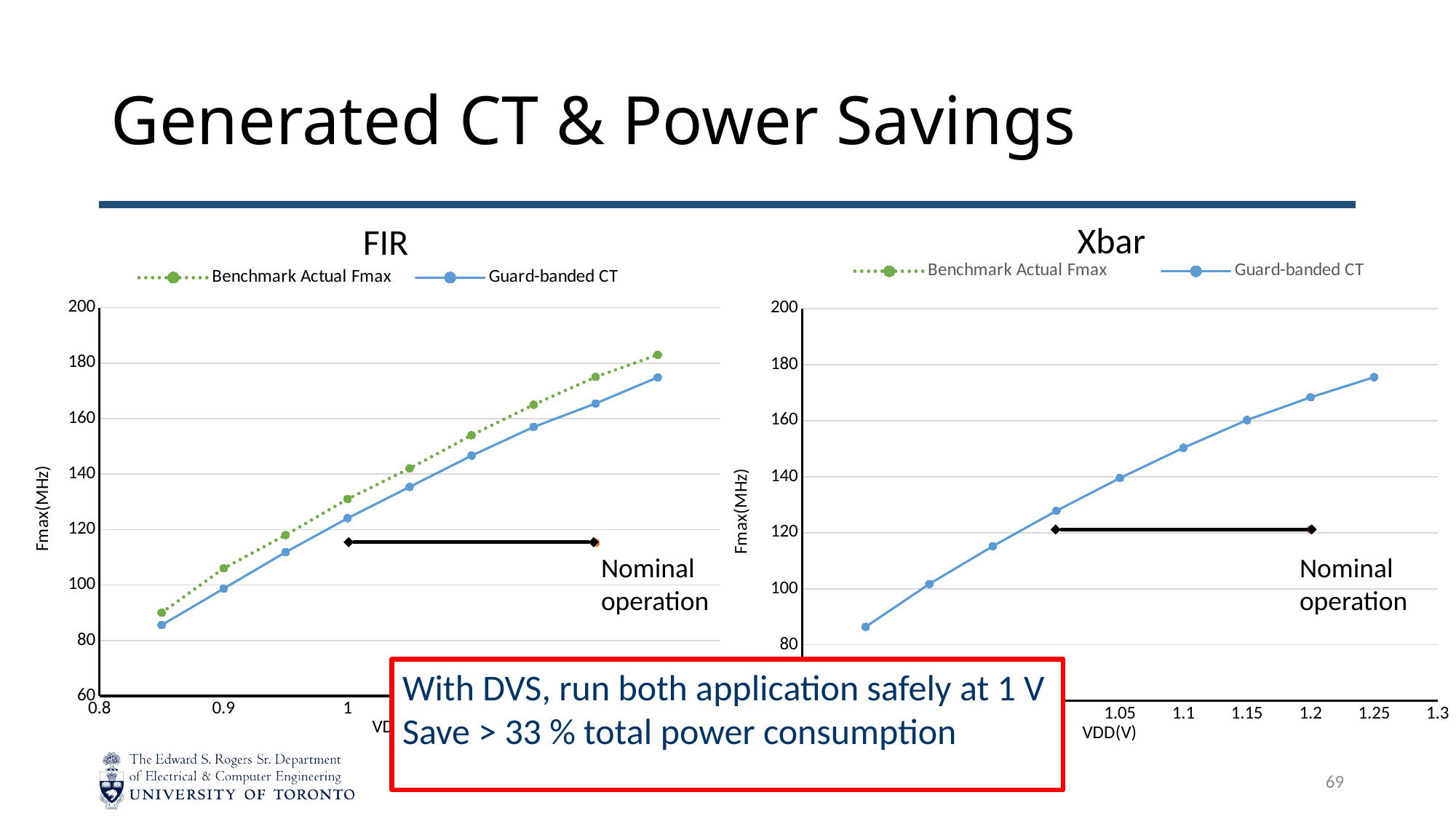
In the FIR chart, is the Benchmark Actual Fmax value at 0.9 V greater or less than 100? greater In the Xbar chart, is the Guard-banded CT value at 1.2 V greater or less than 160? greater What kind of chart is the FIR chart? line chart How many data points are plotted for the Guard-banded CT series in the Xbar chart? 9 In the Xbar chart, is the Guard-banded CT value at 1.25 V greater or less than 180? less In the FIR chart, at 1.2 V, which series has the higher value: Benchmark Actual Fmax or Guard-banded CT? Benchmark Actual Fmax In the FIR chart, do the Guard-banded CT values rise or fall as VDD increases? rise In the Xbar chart, at which VDD value does the Guard-banded CT series reach its highest point? 1.25 How many series does the legend of the Xbar chart list? 2 In the FIR chart, which series is shown with a dotted green line? Benchmark Actual Fmax What is the y-axis label of the Xbar chart? Fmax(MHz)